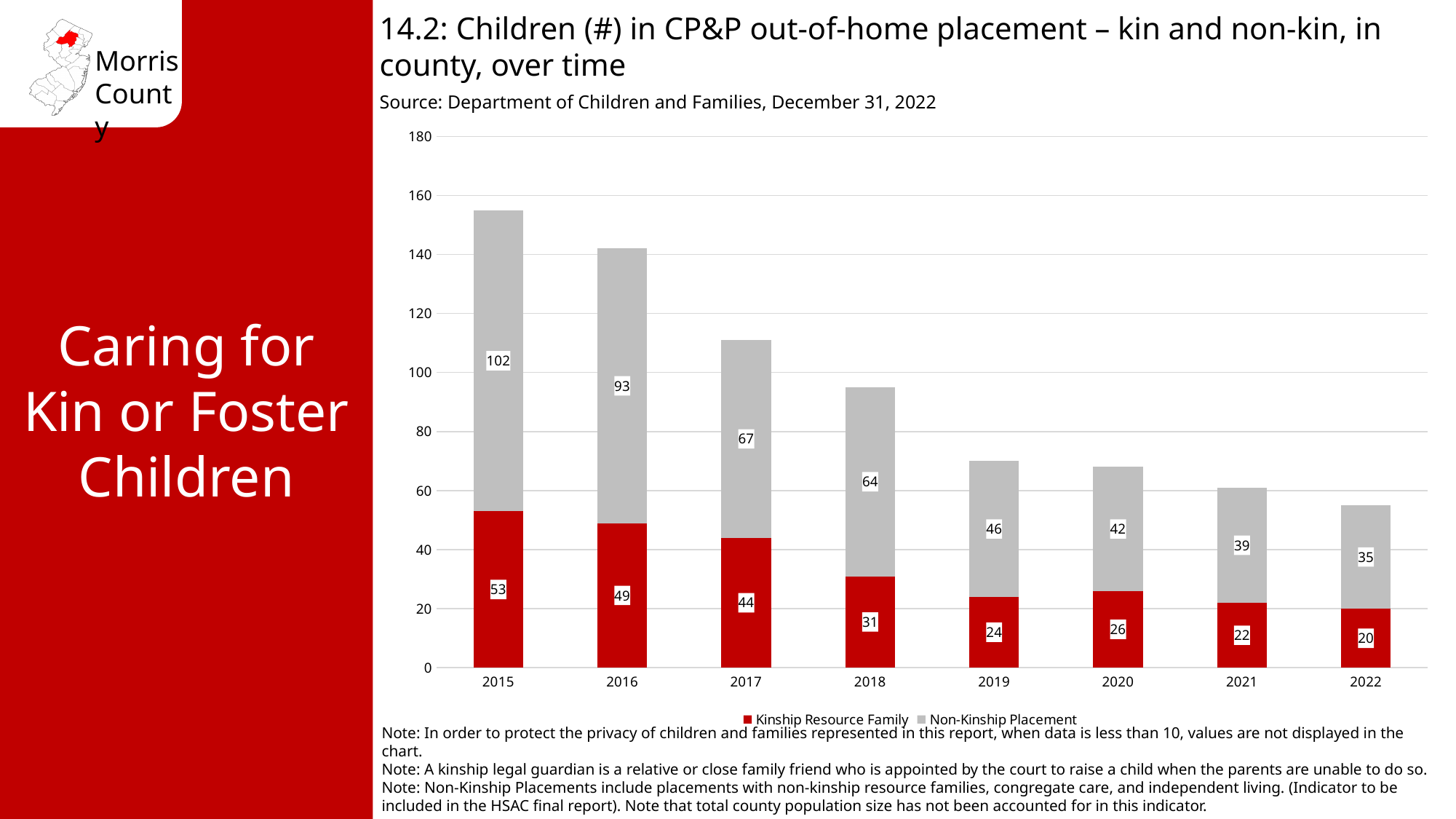
How many years are shown on the x axis? 8 Is the total of the stacked bar for 2015 greater or less than 140? greater What is the Kinship Resource Family value for 2015? 53 Which year has the lowest Kinship Resource Family value? 2022 What is the total of the stacked bar for 2021? 61 Do the Non-Kinship Placement values rise or fall from 2015 to 2022? fall How many series does the legend list? 2 What is the Non-Kinship Placement value for 2018? 64 Which year has the highest Non-Kinship Placement value? 2015 What is the difference between the Non-Kinship Placement values for 2016 and 2017? 26 Which is larger, the Kinship Resource Family value for 2019 or for 2020? 2020 What is the Kinship Resource Family value for 2022? 20